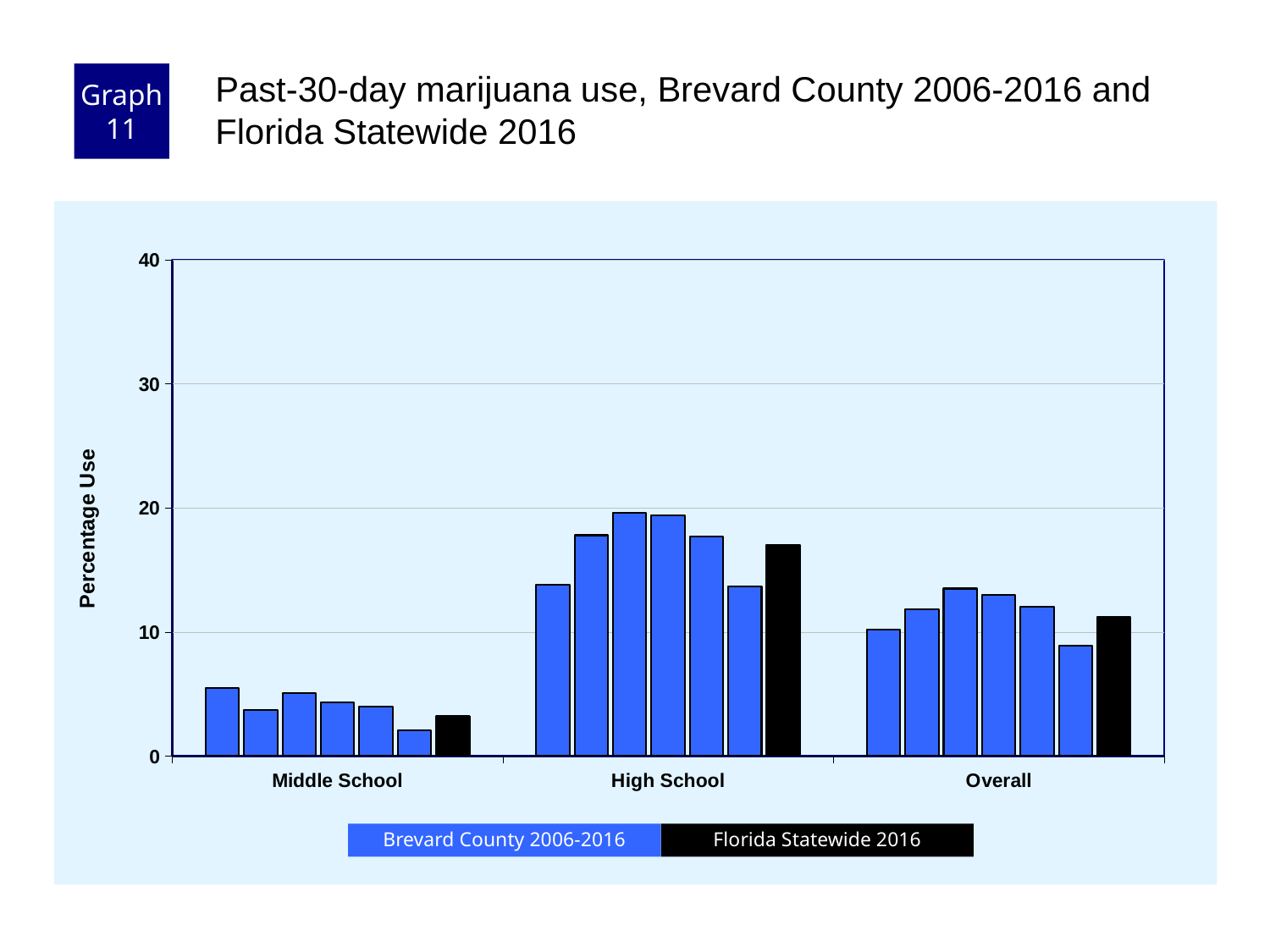
How many series does the legend list? 2 Which is larger, the Florida Statewide 2016 value for High School or for Overall? High School Is the Florida Statewide 2016 value for Middle School greater or less than 10? less Are all of the Brevard County 2006-2016 bars for High School greater or less than 10? greater Is the Florida Statewide 2016 value for High School greater or less than 10? greater Which category has the highest Florida Statewide 2016 value? High School What is the label on the y axis? Percentage Use What kind of chart is shown on the slide? bar chart What colour are the Florida Statewide 2016 bars? black Which category has the lowest Florida Statewide 2016 value? Middle School How many categories are shown on the x axis? 3